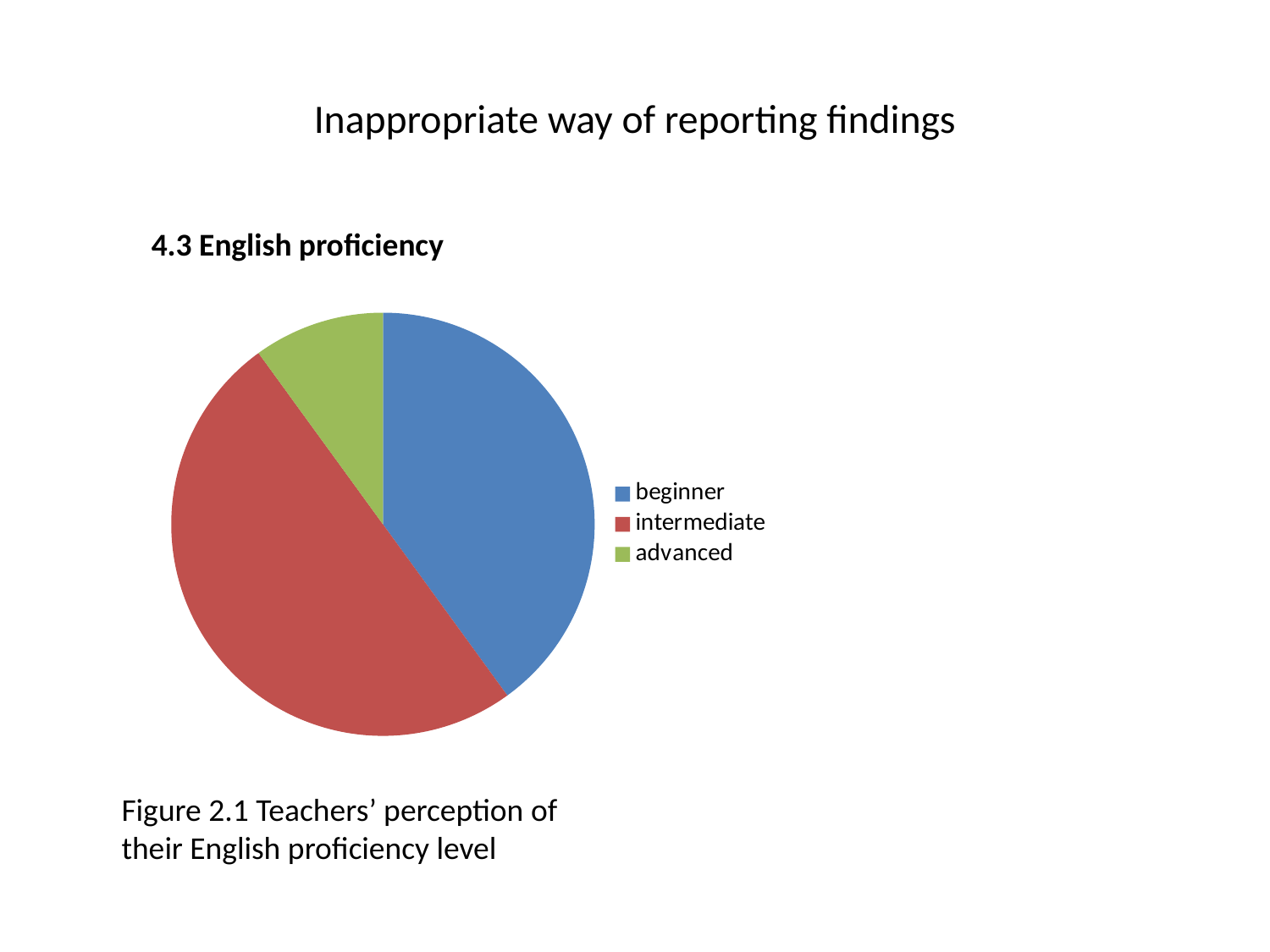
How many slices does the pie chart have? 3 Which slice is larger, beginner or advanced? beginner What kind of chart is shown on the slide? pie chart How many entries does the legend of the pie chart list? 3 Which slice is larger, beginner or intermediate? intermediate Which category has the largest slice of the pie chart? intermediate What colour is the intermediate slice in the pie chart? red Which slice is larger, intermediate or advanced? intermediate Which category has the smallest slice of the pie chart? advanced What is the figure caption below the pie chart? Figure 2.1 Teachers' perception of their English proficiency level